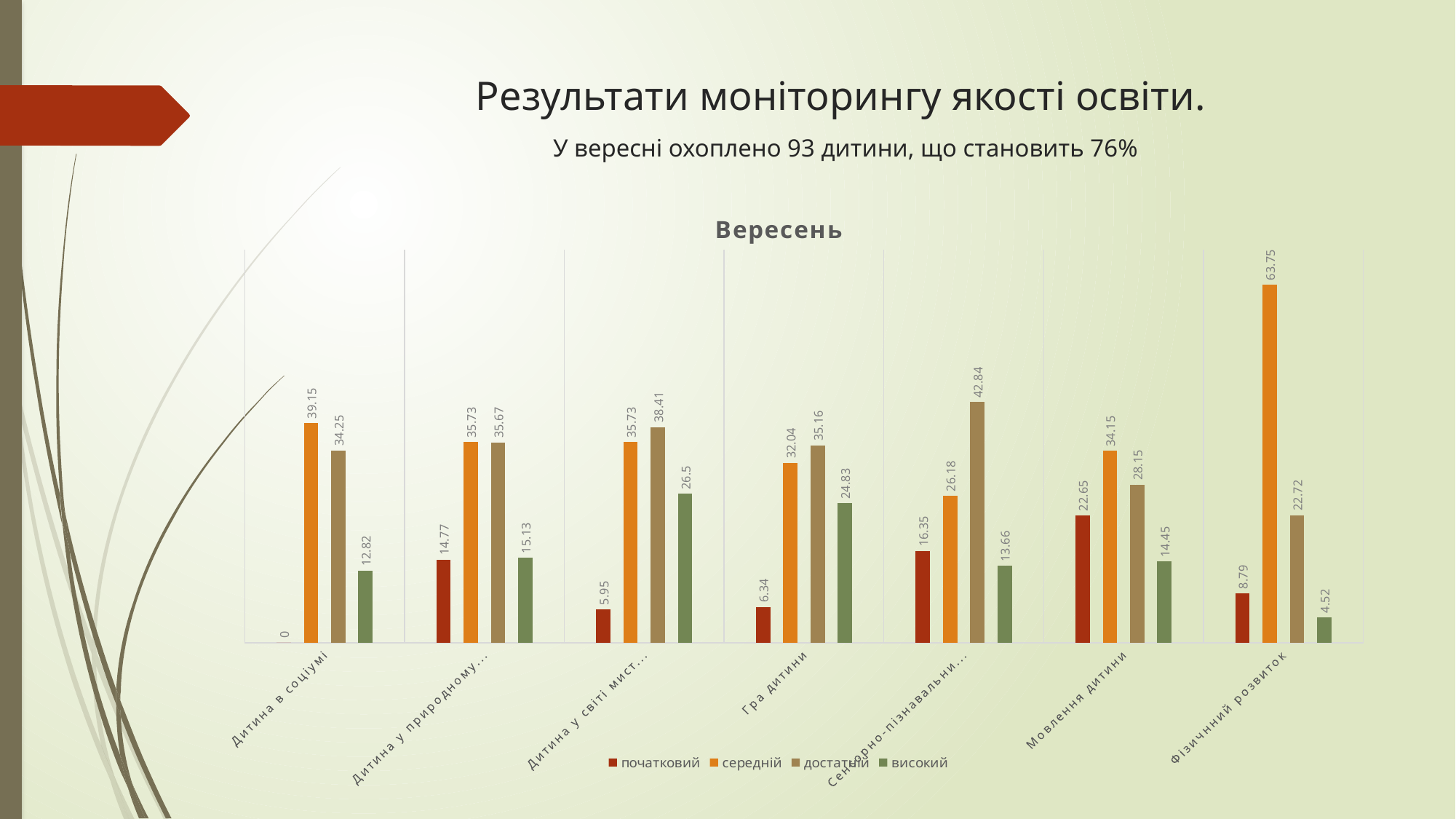
How many categories are shown on the x axis? 7 What is the title of the chart? Вересень What is the value of the початковий series for Мовлення дитини? 22.65 What is the value of the середній series for Фізичнний розвиток? 63.75 For Гра дитини, which is larger: the середній value or the достатній value? достатній What is the value of the достатній series for Дитина в соціумі? 34.25 Which category has the lowest value for the високий series? Фізичнний розвиток What is the value of the високий series for Гра дитини? 24.83 Which category has the highest value for the середній series? Фізичнний розвиток What kind of chart is shown on the slide? bar chart How many series does the legend list? 4 What is the difference between the середній and достатній values for Мовлення дитини? 6